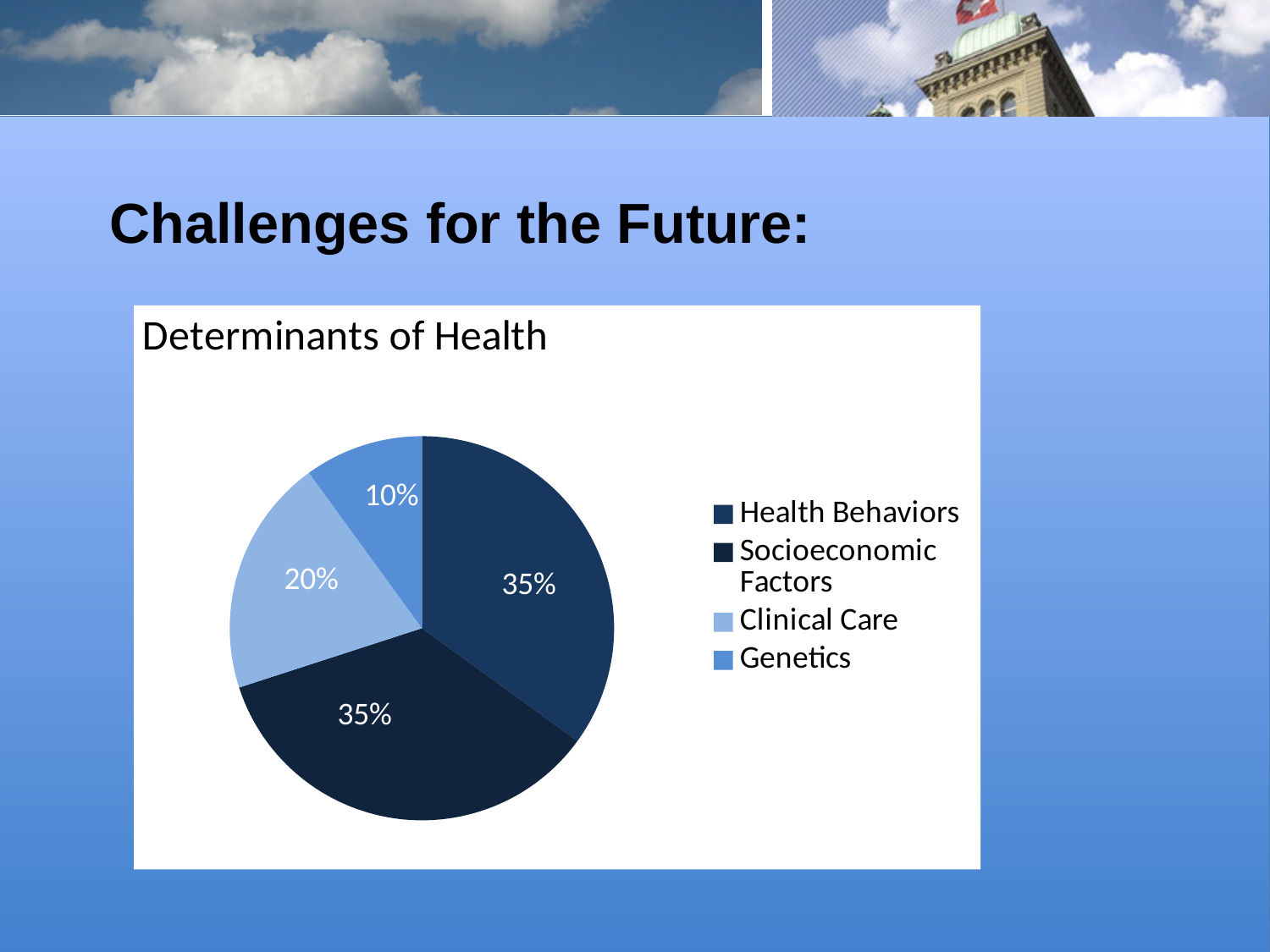
What is the difference in percentage points between the Clinical Care slice and the Genetics slice? 10 What is the difference in percentage points between the Health Behaviors slice and the Clinical Care slice? 15 What share of the pie does Clinical Care represent? 20% What is the title of the chart? Determinants of Health Which category has the smallest slice of the pie? Genetics How many entries does the legend list? 4 What kind of chart is shown on the slide? pie chart What share of the pie does Health Behaviors represent? 35% What share of the pie does Genetics represent? 10% How many categories does the pie chart show? 4 What share of the pie does Socioeconomic Factors represent? 35% Which is larger, the slice for Clinical Care or the slice for Genetics? Clinical Care